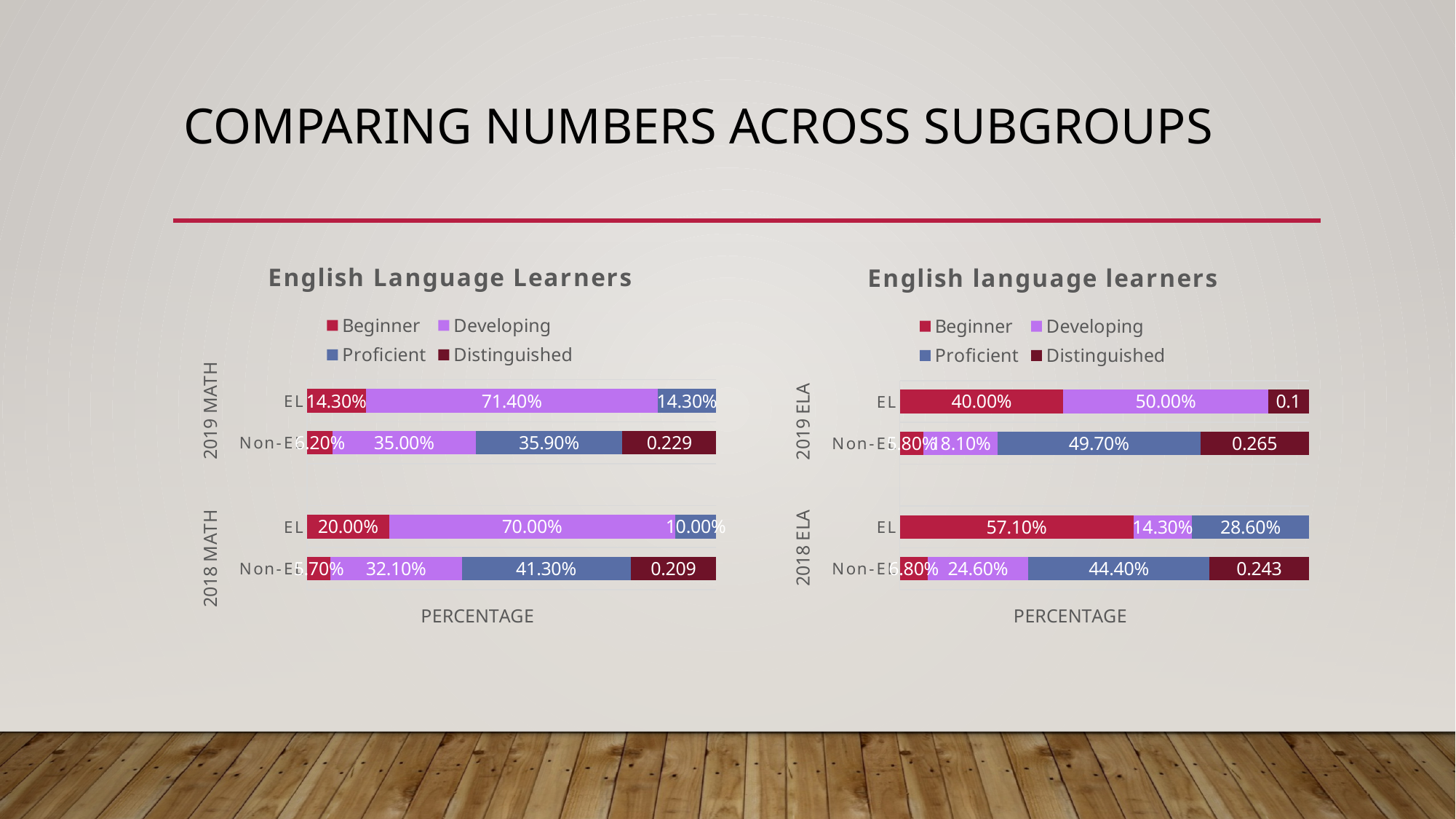
What is the x-axis label of the left chart (Math)? PERCENTAGE In the right chart (ELA), which segment is largest in the 2019 ELA Non-EL bar? Proficient In the left chart (Math), what is the Proficient value for 2018 Math Non-EL? 41.30% In the right chart (ELA), what is the Distinguished value for 2018 ELA Non-EL? 0.243 What kind of chart is the right chart (ELA)? Stacked bar chart In the left chart (Math), which segment is largest in the 2018 Math EL bar? Developing In the left chart (Math), what is the Developing value for 2019 Math EL? 71.40% In the right chart (ELA), what is the Beginner value for 2018 ELA EL? 57.10% In the right chart (ELA), which is larger for 2018 ELA EL: Developing or Proficient? Proficient How many series does the legend of the left chart (Math) list? 4 In the right chart (ELA), what is the Proficient value for 2019 ELA Non-EL? 49.70% In the left chart (Math), what is the difference between the Developing values for 2019 Math EL and 2018 Math EL? 1.40%